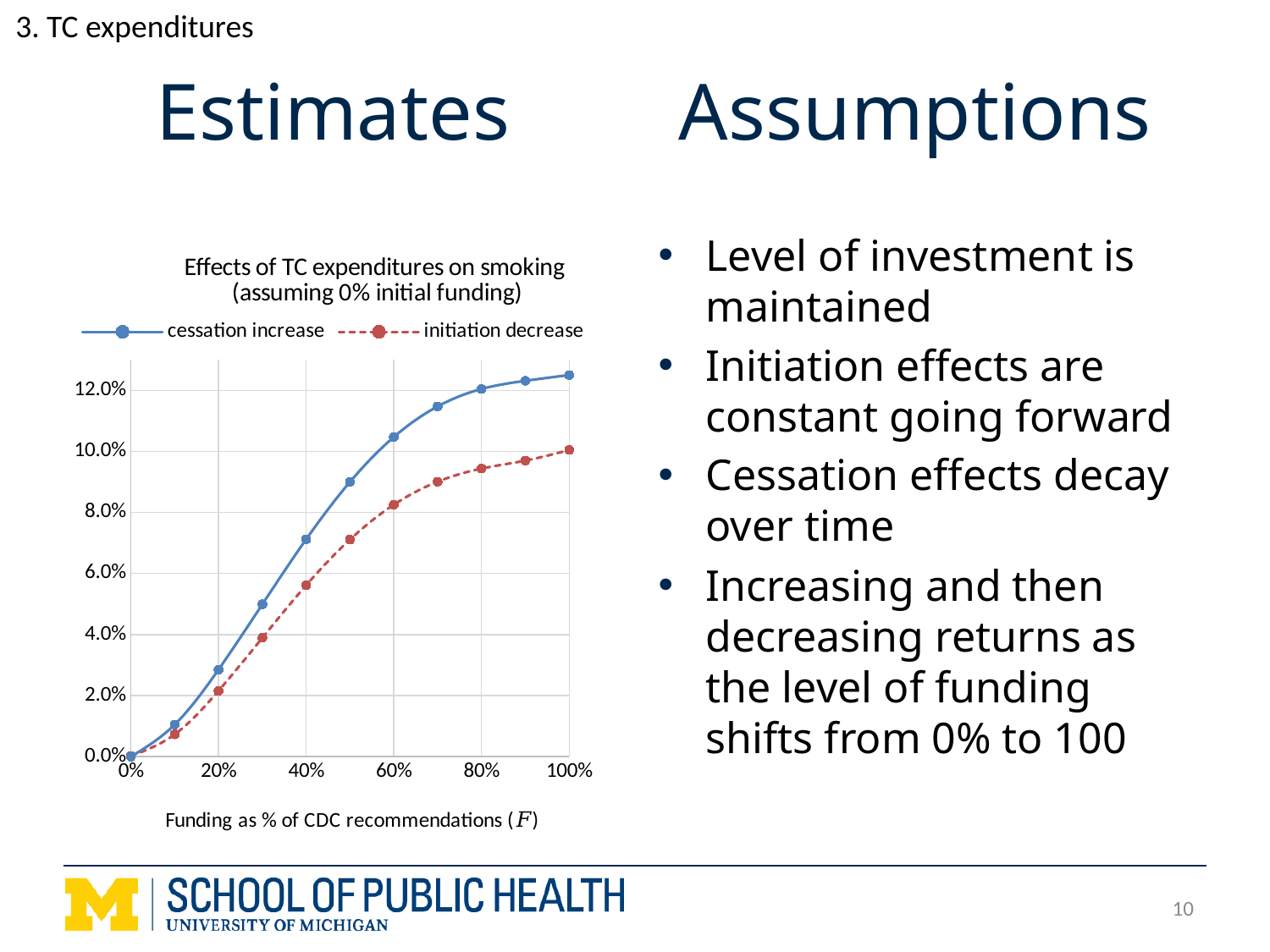
Is the cessation increase value at 30% funding greater or less than 4.0%? greater Is the initiation decrease value at 40% funding greater or less than 6.0%? less How many data points are plotted for the cessation increase series? 11 Does the cessation increase series rise or fall as funding increases from 0% to 100%? rise Which series is drawn with a dashed red line? initiation decrease Is the cessation increase value at 50% funding greater or less than 8.0%? greater At 50% funding, which series has the larger value, cessation increase or initiation decrease? cessation increase What is the title of the chart? Effects of TC expenditures on smoking (assuming 0% initial funding) How many series does the chart legend list? 2 What kind of chart is shown on the slide? line chart